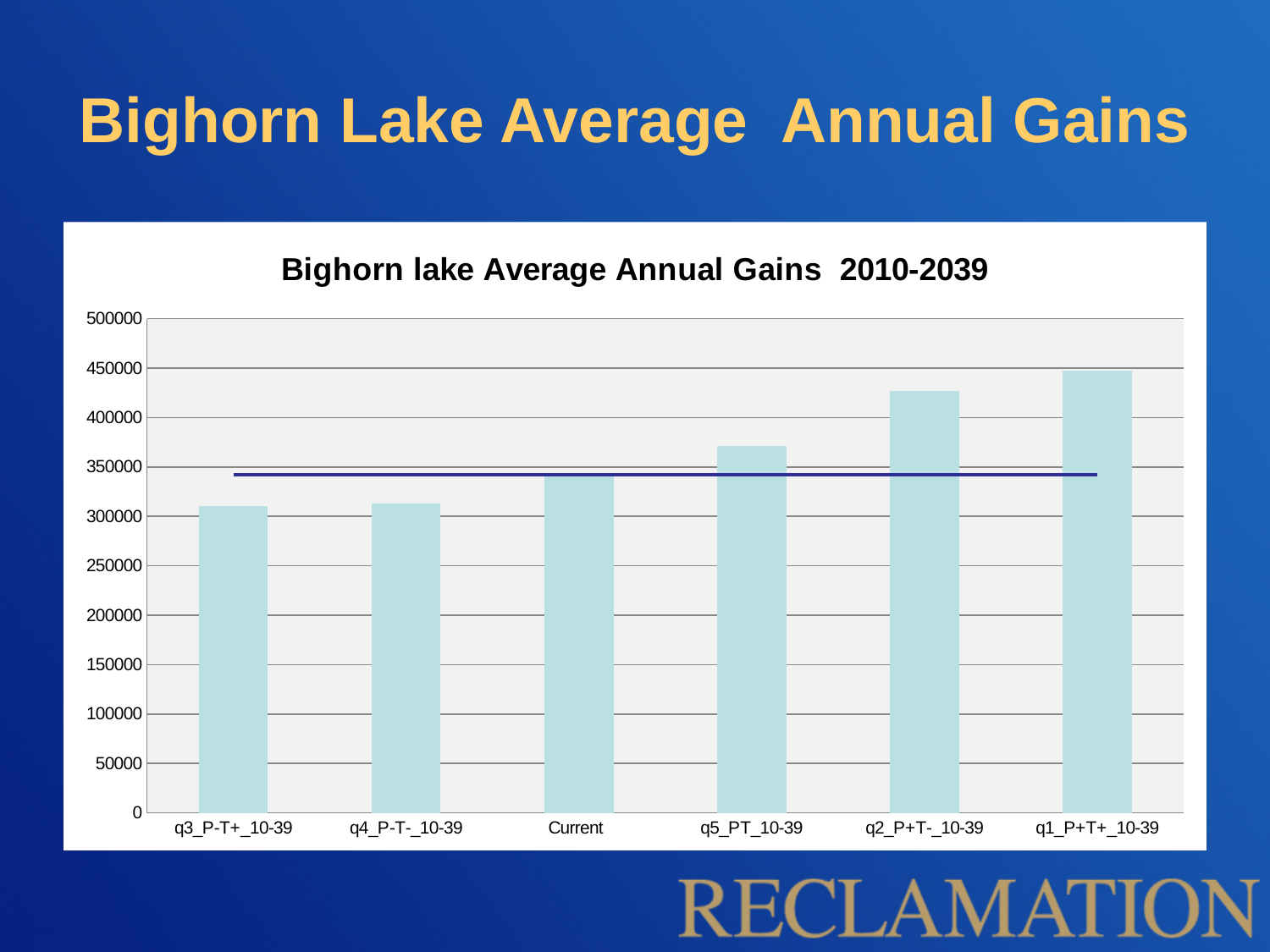
Which is larger, the value for Current or the value for q4_P-T-_10-39? Current Is the value for q3_P-T+_10-39 greater or less than 350000? less Is the value for q5_PT_10-39 greater or less than 350000? greater Is the value for Current greater or less than 300000? greater Which category has the highest value in the chart? q1_P+T+_10-39 Which is larger, the value for q2_P+T-_10-39 or the value for q5_PT_10-39? q2_P+T-_10-39 What kind of chart is shown on the slide? combination bar and line chart Do the bar values generally rise or fall from left to right along the x axis? rise What is the title of the chart? Bighorn lake Average Annual Gains 2010-2039 How many categories are shown on the x axis of the chart? 6